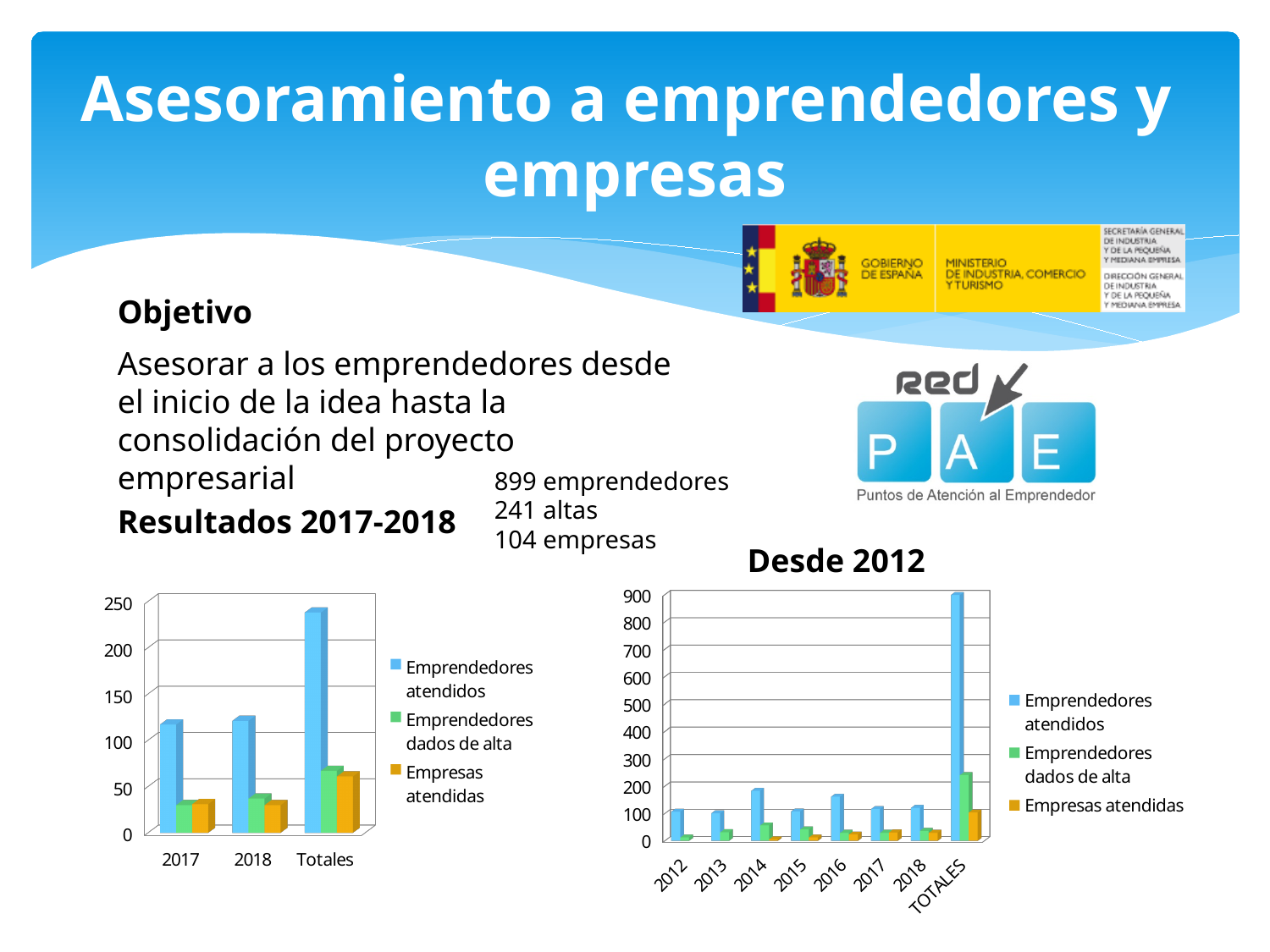
In the chart titled "Desde 2012", is the value of Emprendedores dados de alta for TOTALES greater or less than 200? greater What is the title of the chart on the right side of the slide? Desde 2012 In the chart titled "Desde 2012", which year from 2012 to 2018 has the highest value for Emprendedores atendidos? 2014 In the chart titled "Desde 2012", is the value of Emprendedores atendidos for 2014 greater or less than 200? less How many categories are shown on the x axis of the left chart? 3 In the left chart, is the value of Emprendedores atendidos for Totales greater or less than 200? greater How many series does the legend of the left chart list? 3 What type of chart is the chart titled "Desde 2012"? Bar chart How many categories are shown on the x axis of the chart titled "Desde 2012"? 8 In the chart titled "Desde 2012", is the value of Emprendedores atendidos larger for 2014 or for 2016? 2014 In the left chart, which series is shown in orange? Empresas atendidas